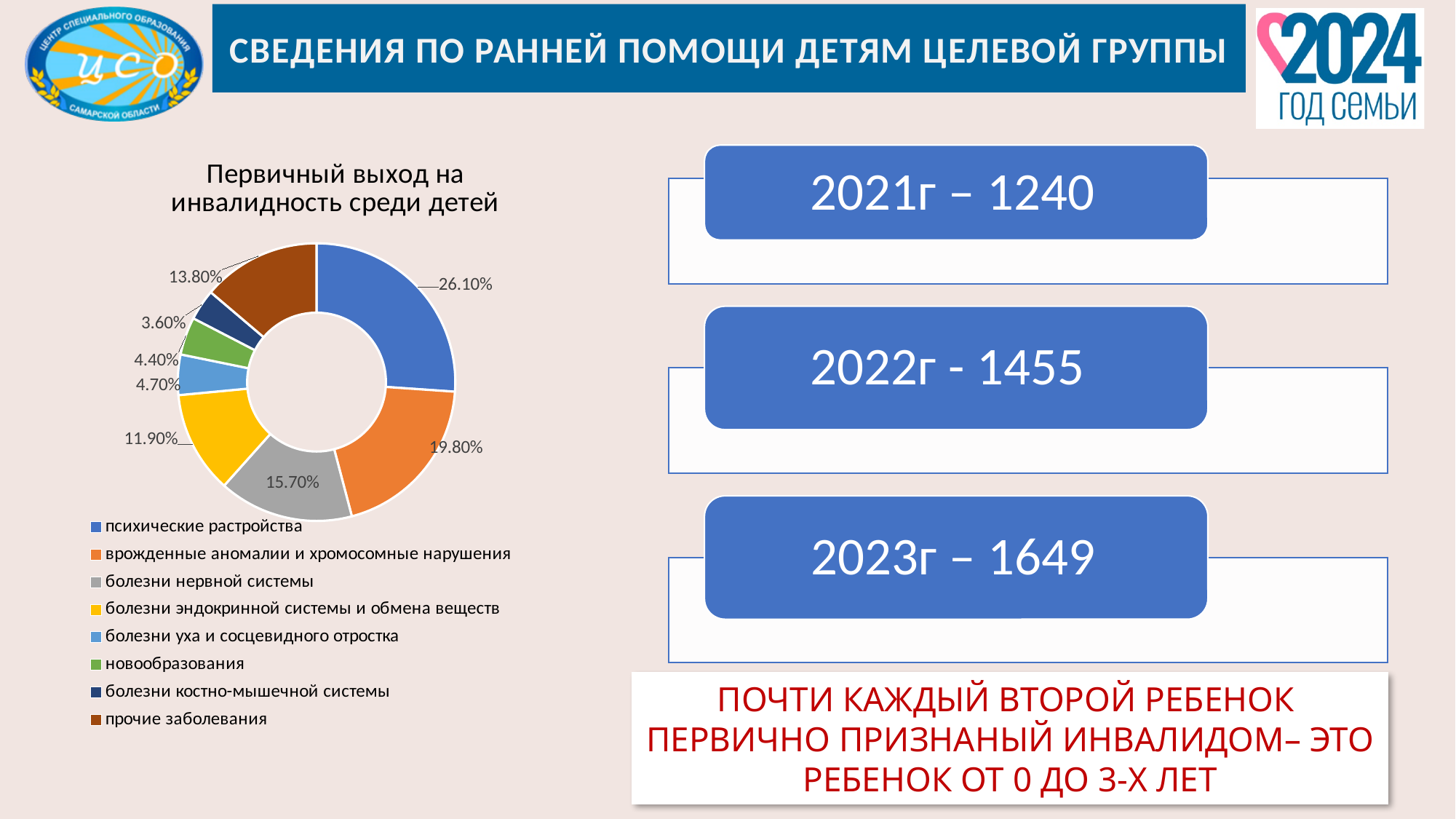
What share of the chart is 'новообразования'? 4.40% How many categories does the chart show? 8 What share of the chart is 'психические расстройства'? 26.10% What share of the chart is 'болезни нервной системы'? 15.70% Which category has the largest share in the chart? психические расстройства What is the difference between the shares of 'психические расстройства' and 'врожденные аномалии и хромосомные нарушения'? 6.30% What kind of chart is shown on the slide? doughnut (pie) chart Which is larger: the share of 'болезни эндокринной системы и обмена веществ' or 'прочие заболевания'? прочие заболевания What share of the chart is 'прочие заболевания'? 13.80% Which category has the smallest share in the chart? болезни костно-мышечной системы What is the title of the chart on the slide? Первичный выход на инвалидность среди детей What share of the chart is 'врожденные аномалии и хромосомные нарушения'? 19.80%